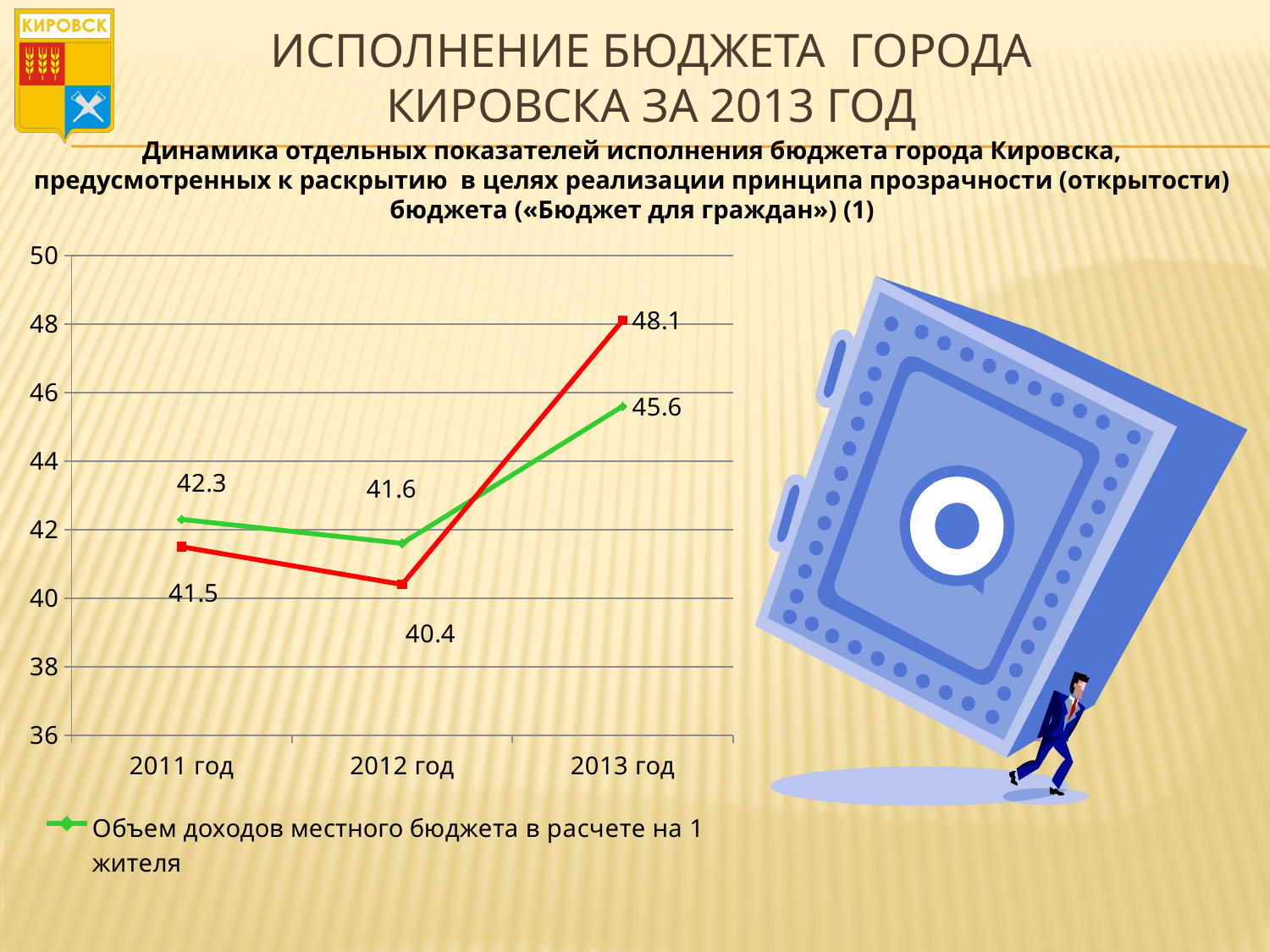
In which year does the green line (Объем доходов местного бюджета в расчете на 1 жителя) have its lowest value? 2012 год How many years are shown on the x axis of the chart? 3 Is the value of the red line for 2013 год greater or less than 46? greater How does the green line (Объем доходов местного бюджета в расчете на 1 жителя) change from 2012 год to 2013 год? it rises What is the value of the green line (Объем доходов местного бюджета в расчете на 1 жителя) for 2011 год? 42.3 What is the value of the red line for 2013 год? 48.1 What kind of chart is shown on the slide? line chart What is the value of the green line (Объем доходов местного бюджета в расчете на 1 жителя) for 2013 год? 45.6 In which year does the red line reach its highest value? 2013 год What is the difference between the red line and the green line values in 2013 год? 2.5 Which line has the larger value in 2012 год, the red line or the green line? the green line What is the value of the red line for 2012 год? 40.4